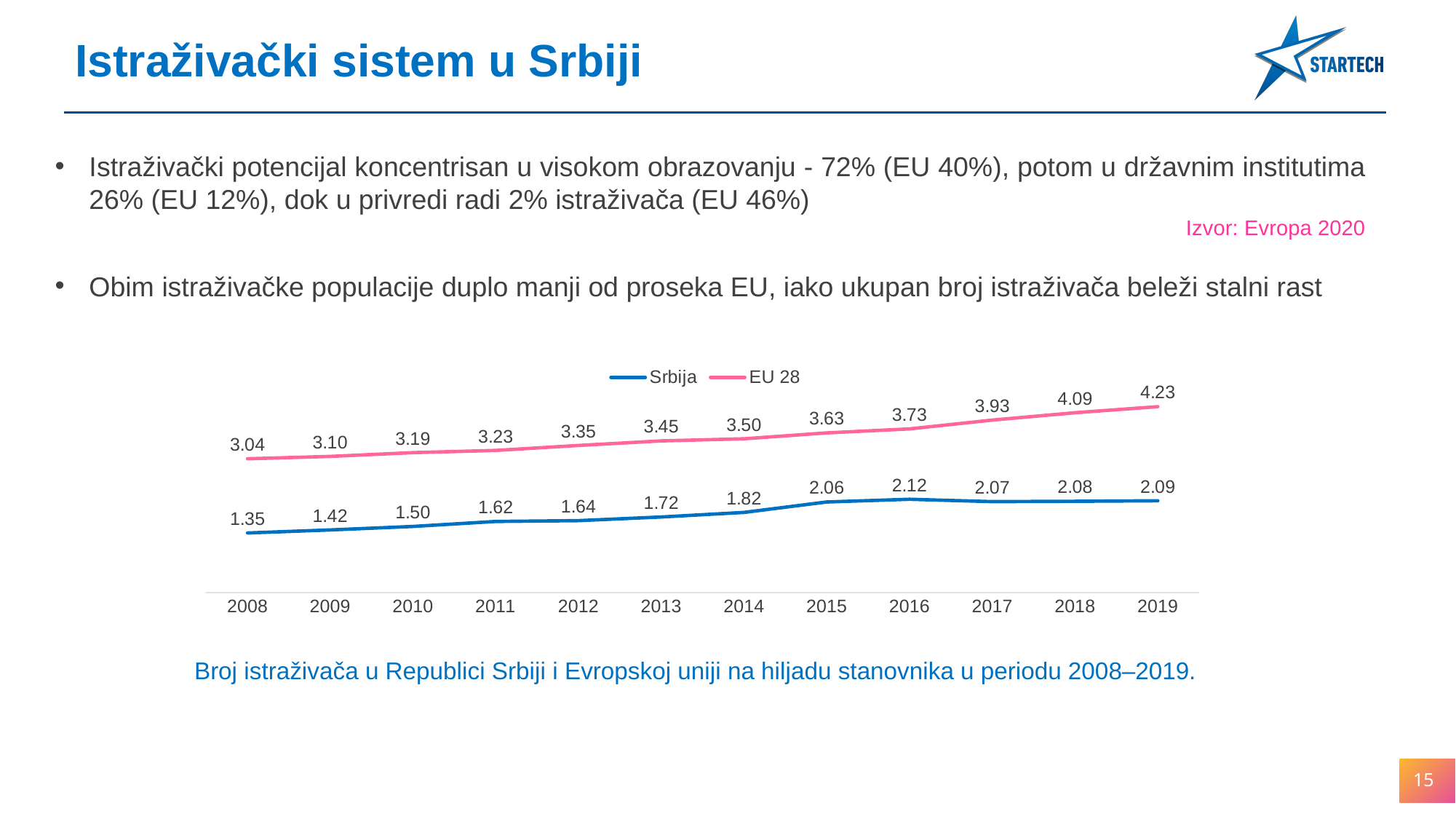
What is the difference between the EU 28 and Srbija values in 2019? 2.14 What is the value for Srbija in 2015? 2.06 In which year is the EU 28 series at its lowest? 2008 How many series does the legend list? 2 What kind of chart is shown on the slide? Line chart What colour is the line for Srbija? Blue How many years are shown on the x axis? 12 Does the EU 28 series rise or fall from 2008 to 2019? Rise What is the value for EU 28 in 2012? 3.35 What is the value for Srbija in 2008? 1.35 Which series has the larger value in 2014, Srbija or EU 28? EU 28 In which year is the Srbija series at its highest? 2016